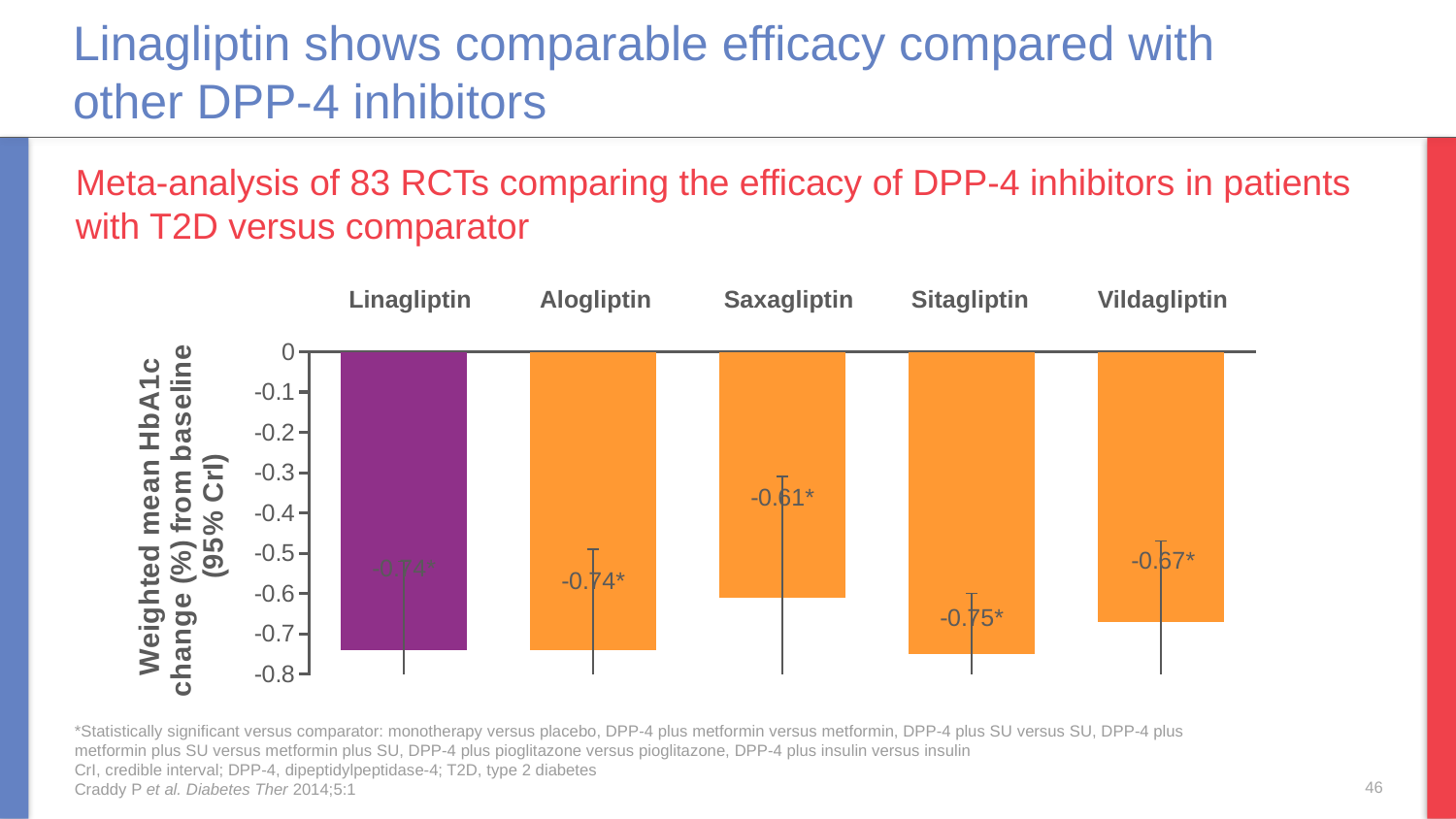
Which has a larger HbA1c reduction from baseline, Saxagliptin or Vildagliptin? Vildagliptin What is the difference between the HbA1c change for Alogliptin and Saxagliptin? 0.13 What is the weighted mean HbA1c change from baseline for Vildagliptin? -0.67* Is the value for Linagliptin greater or less than -0.7? less What is the difference between the HbA1c change for Sitagliptin and Vildagliptin? 0.08 What is the weighted mean HbA1c change from baseline for Alogliptin? -0.74* What type of chart is shown on the slide? Bar chart What is the weighted mean HbA1c change from baseline for Sitagliptin? -0.75* Which DPP-4 inhibitor shows the smallest reduction in HbA1c (the bar closest to zero)? Saxagliptin Which DPP-4 inhibitor's bar is coloured purple rather than orange? Linagliptin How many DPP-4 inhibitors are plotted in the chart? 5 What is the weighted mean HbA1c change from baseline for Saxagliptin? -0.61*